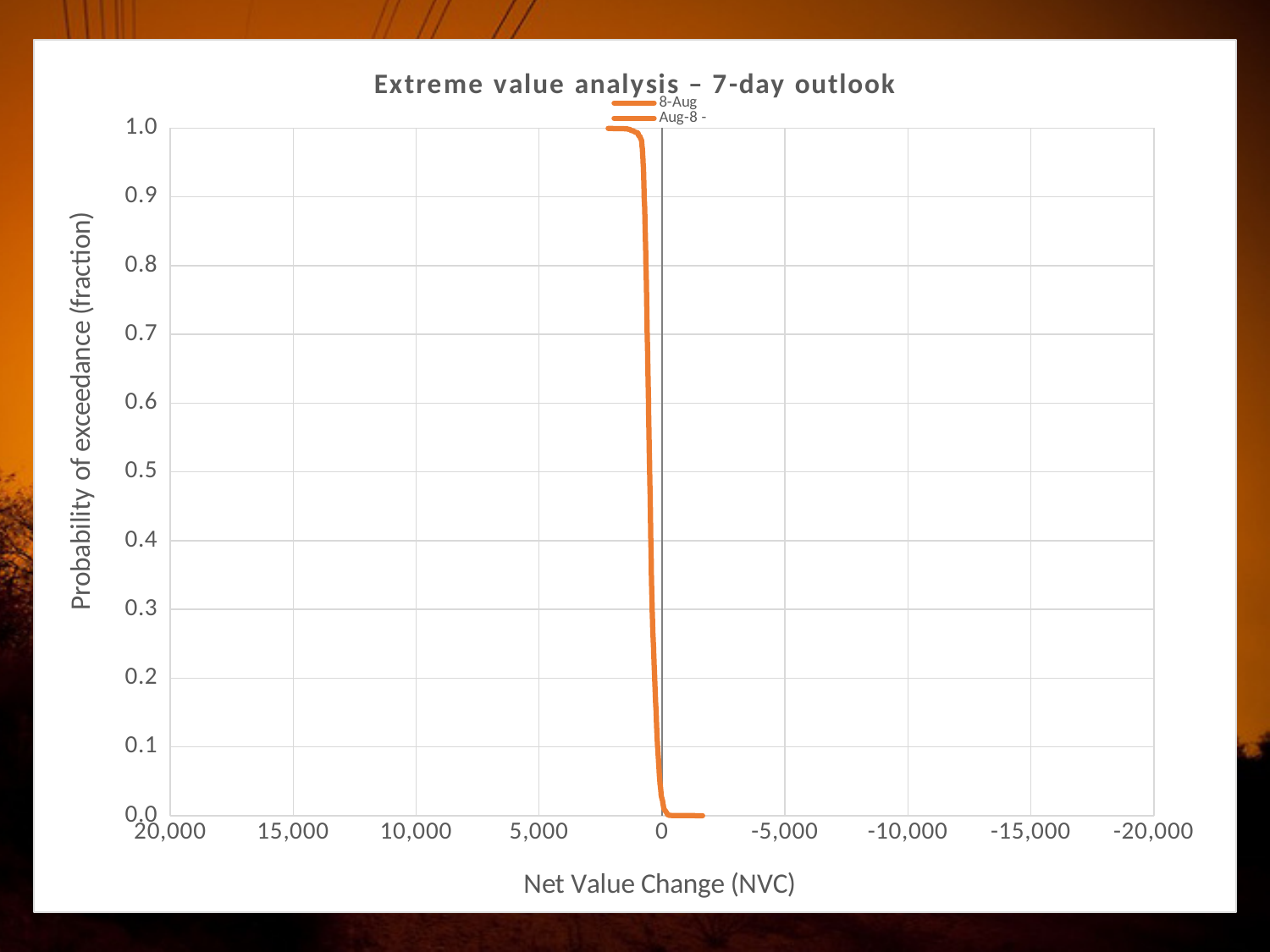
What is the title of the chart? Extreme value analysis – 7-day outlook Moving from left to right along the x axis, does the plotted probability of exceedance rise or fall? Fall How many series does the legend list? 2 What is the leftmost tick value shown on the x axis? 20,000 At a probability of exceedance of 0.5, is the Net Value Change greater or less than 5,000? less At a probability of exceedance of 0.5, is the Net Value Change greater or less than -5,000? greater What kind of chart is shown on the slide? Line chart What is the highest value shown on the y axis? 1.0 What is the label of the x axis? Net Value Change (NVC)